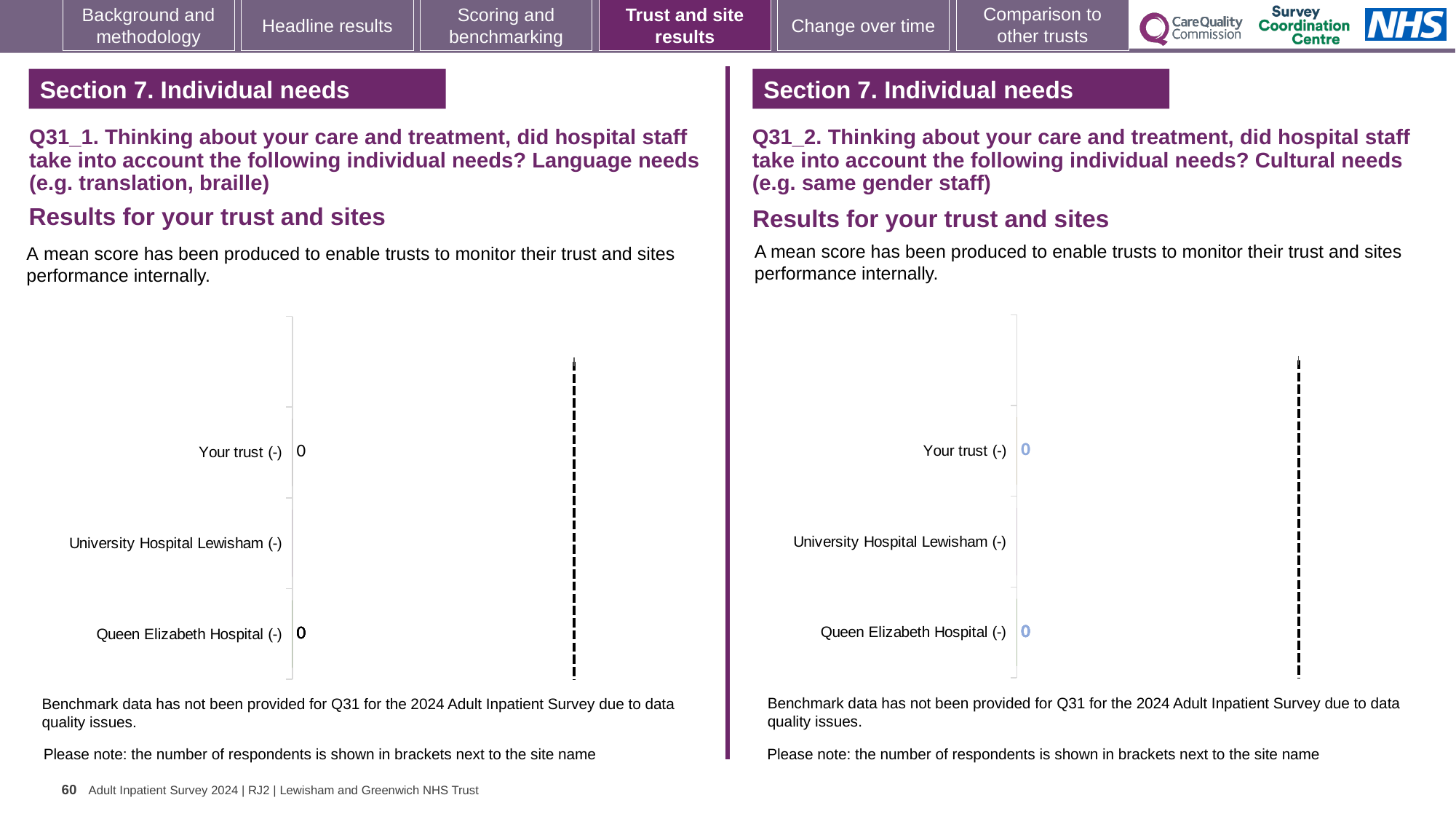
On the right chart (Q31_2, Cultural needs), what value is shown for Your trust? 0 How many categories are listed on the left chart (Q31_1, Language needs)? 3 On the right chart (Q31_2, Cultural needs), what value is shown for Queen Elizabeth Hospital? 0 On the left chart (Q31_1, Language needs), which category is listed between Your trust and Queen Elizabeth Hospital? University Hospital Lewisham (-) On the left chart (Q31_1, Language needs), what value is shown for Your trust? 0 How many categories are listed on the right chart (Q31_2, Cultural needs)? 3 On the left chart (Q31_1, Language needs), what value is shown for Queen Elizabeth Hospital? 0 What kind of chart is used on the left side of the slide (Q31_1, Language needs)? Bar chart On the right chart (Q31_2, Cultural needs), what is shown in brackets next to each site name for the number of respondents? -